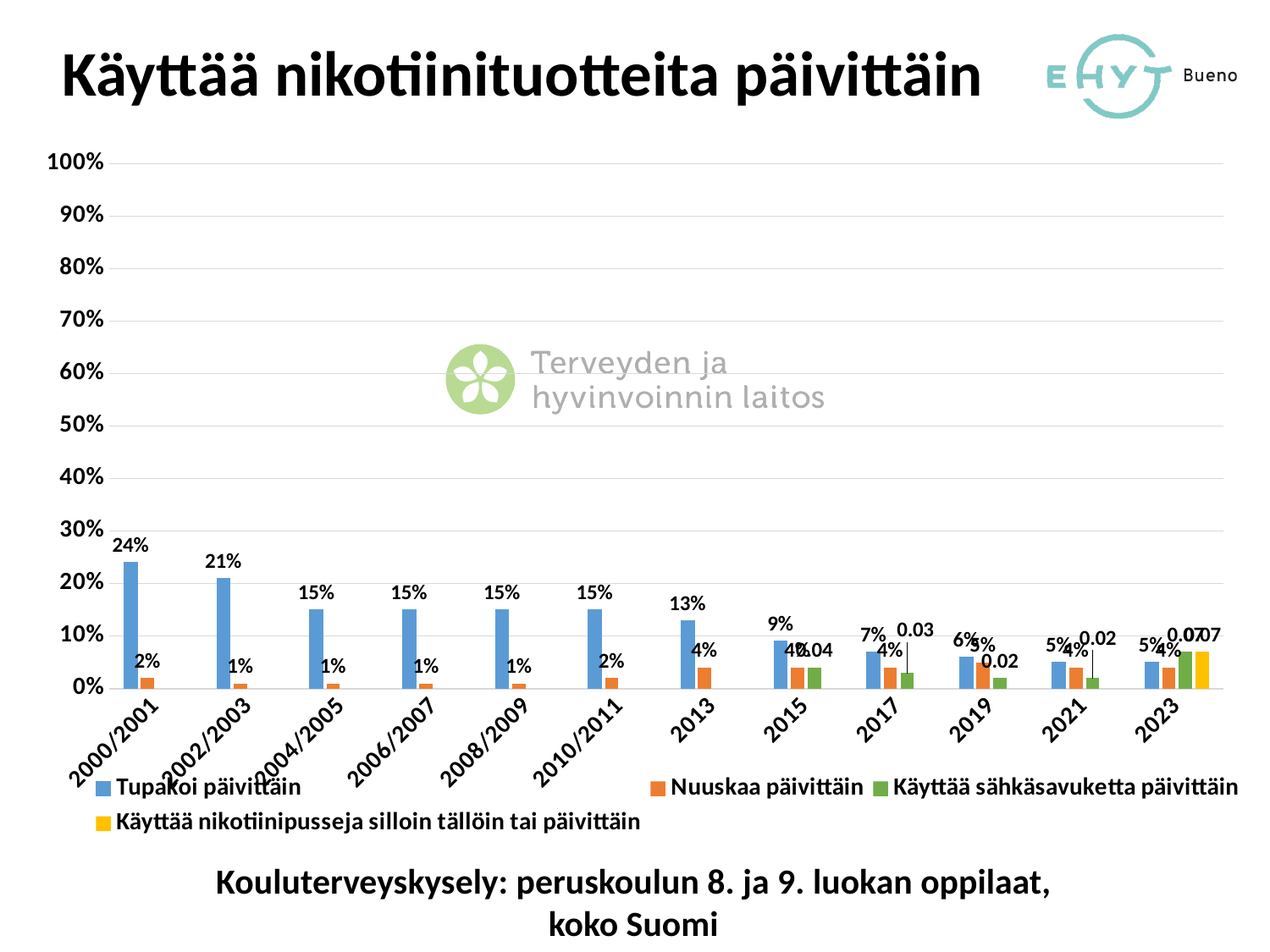
How many year categories are shown on the x axis? 12 Does Tupakoi päivittäin rise or fall from 2000/2001 to 2023? fall What is the value for Nuuskaa päivittäin in 2013? 4% In which year is Tupakoi päivittäin highest? 2000/2001 In 2013, which is larger: Tupakoi päivittäin or Nuuskaa päivittäin? Tupakoi päivittäin What is the value for Tupakoi päivittäin in 2000/2001? 24% What is the difference between Tupakoi päivittäin in 2000/2001 and in 2002/2003? 3% How many series does the legend list? 4 What is the value for Tupakoi päivittäin in 2002/2003? 21% What is the value for Käyttää sähkäsavuketta päivittäin in 2017? 0.03 Is the value for Tupakoi päivittäin in 2004/2005 greater or less than 20%? less What kind of chart is shown on the slide? bar chart